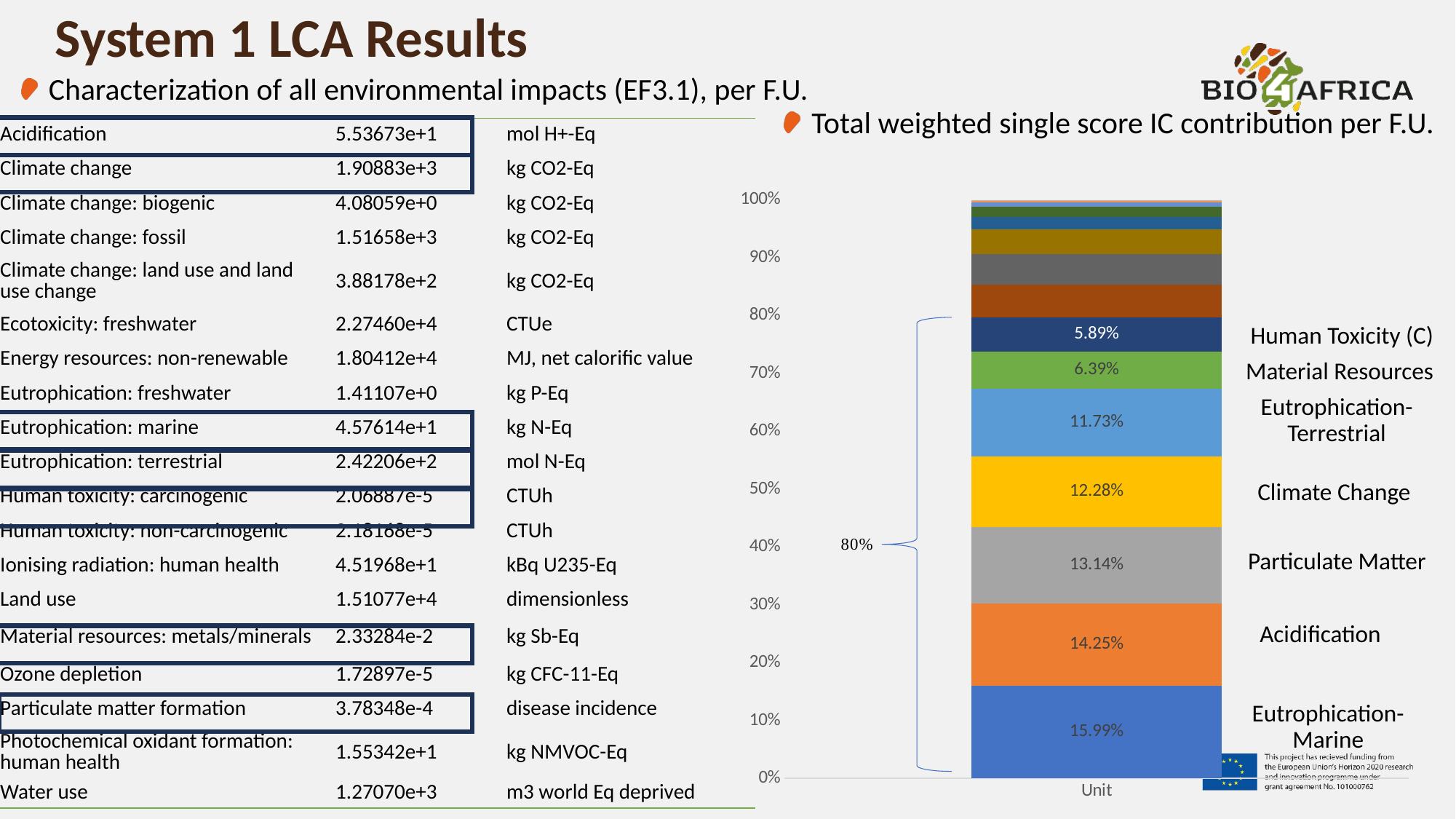
What is the value of the Eutrophication-Marine segment in the stacked bar? 15.99% What is the value of the Climate Change segment in the stacked bar? 12.28% Which is larger, the Material Resources segment or the Eutrophication-Terrestrial segment? Eutrophication-Terrestrial What percentage does the bracket beside the stacked bar indicate for the labelled segments combined? 80% How many segments of the stacked bar have a printed percentage label? 7 What is the difference between the Eutrophication-Marine and Acidification segments? 1.74% What kind of chart is shown on the right of the slide? stacked bar chart What is the value of the Acidification segment in the stacked bar? 14.25% What is the value of the Human Toxicity (C) segment in the stacked bar? 5.89% What is the value of the Particulate Matter segment in the stacked bar? 13.14% Which labelled segment of the stacked bar has the smallest value? Human Toxicity (C) Which labelled segment of the stacked bar has the largest value? Eutrophication-Marine